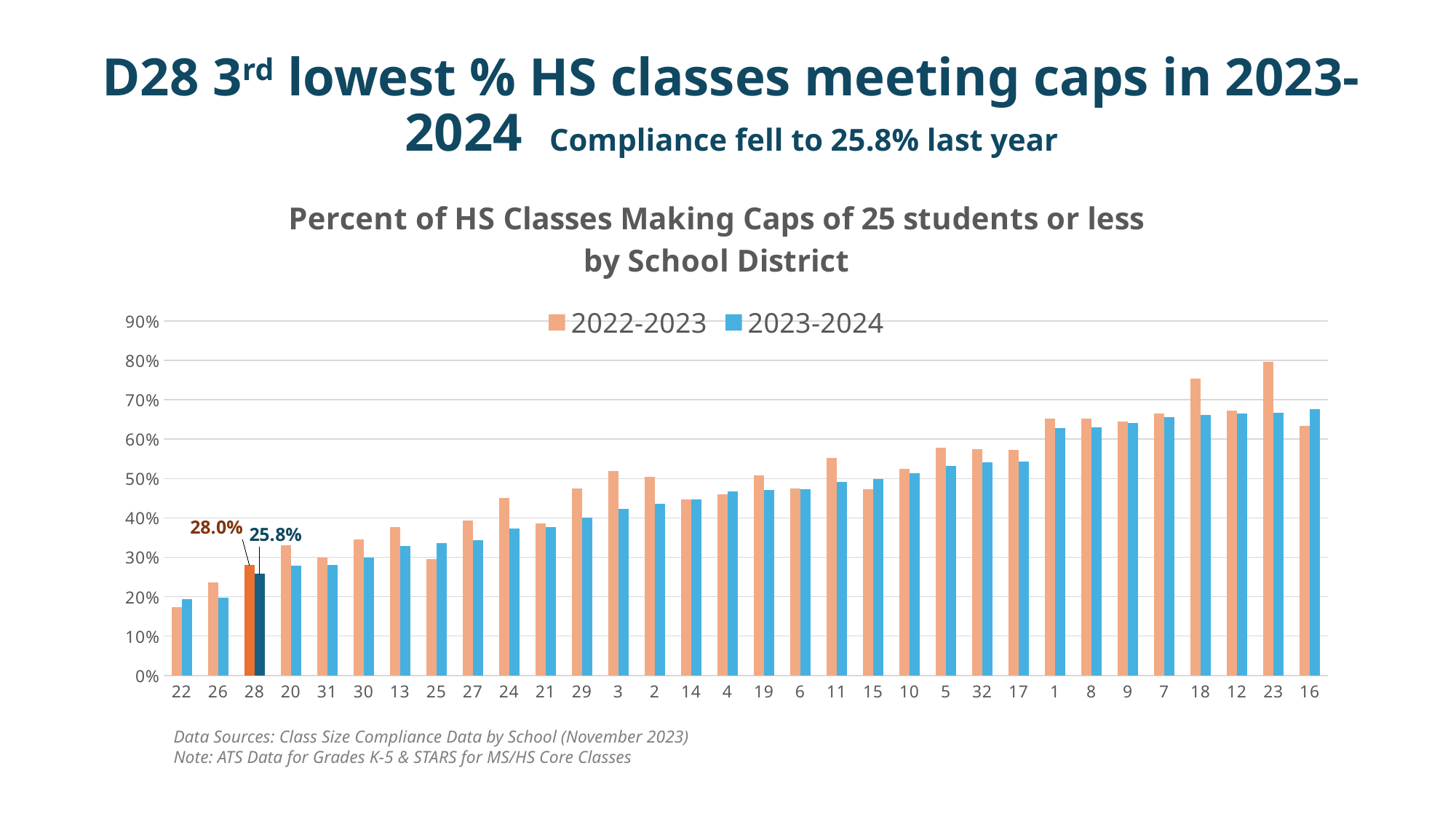
Do the 2023-2024 values generally rise or fall moving from left to right along the x axis? rise What is the 2023-2024 value for district 28? 25.8% Is the 2022-2023 value for district 18 greater or less than 70%? greater Which district has the highest 2022-2023 value? 23 What are the two series named in the legend? 2022-2023 and 2023-2024 What is the 2022-2023 value for district 28? 28.0% How many series does the legend list? 2 By how many percentage points did district 28's value fall from 2022-2023 to 2023-2024? 2.2 percentage points How many school districts are shown on the x axis? 32 What type of chart is shown on the slide? bar chart Which district has the lowest 2023-2024 value? 22 For district 28, which year has the larger value, 2022-2023 or 2023-2024? 2022-2023